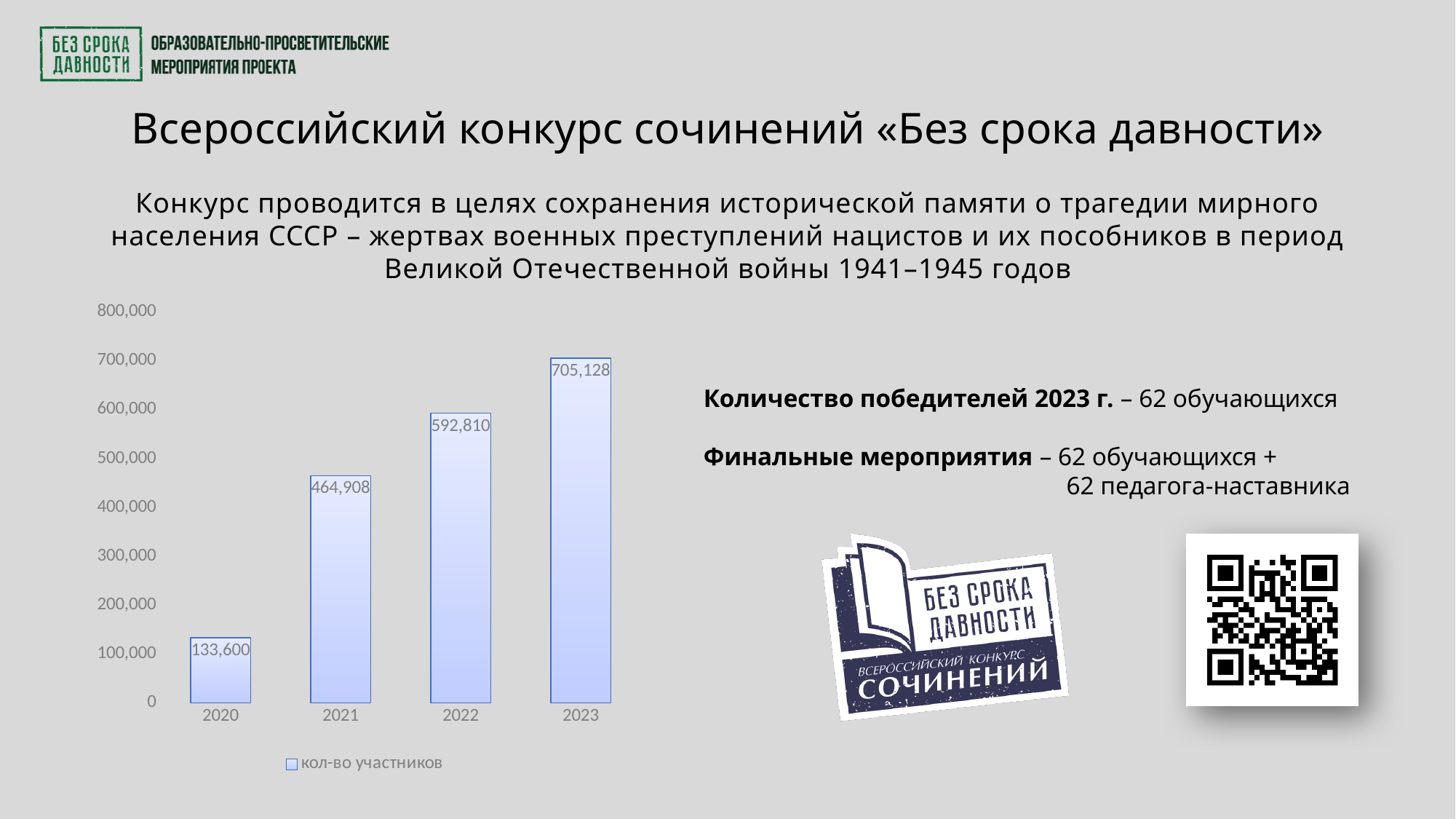
What is the difference in the number of participants between 2021 and 2020? 331,308 Which year had more participants, 2021 or 2022? 2022 Which year has the highest number of participants? 2023 Does the number of participants rise or fall from 2020 to 2023? Rises How many years are shown on the x axis of the chart? 4 What is the difference in the number of participants between 2023 and 2022? 112,318 What is the number of participants in 2021? 464,908 What is the number of participants (кол-во участников) in 2020? 133,600 What is the number of participants in 2023? 705,128 Which year has the lowest number of participants? 2020 What is the number of participants in 2022? 592,810 What kind of chart is shown on the slide? Bar chart